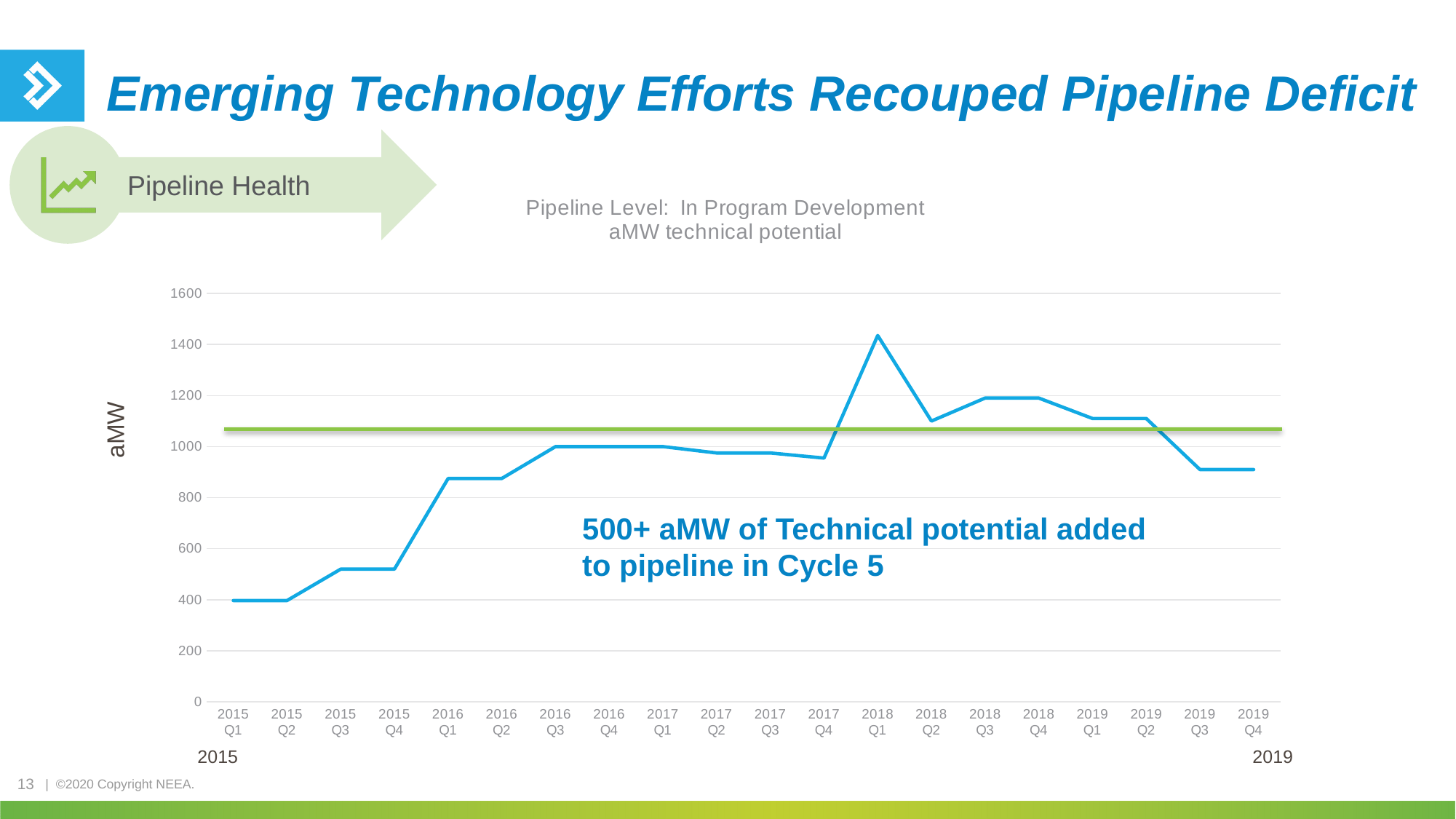
How many quarterly data points are plotted along the x axis? 20 Is the value for 2016 Q1 greater or less than 800? greater Do the values rise or fall from 2015 Q1 to 2016 Q3? rise What kind of chart is shown on the slide? line chart Which is larger, the value for 2018 Q1 or the value for 2019 Q4? 2018 Q1 Is the value for 2019 Q4 greater or less than 1000? less Is the value for 2018 Q1 greater or less than 1200? greater What is the label on the y axis of the chart? aMW Do the values rise or fall from 2018 Q1 to 2018 Q2? fall Which quarter has the highest aMW value on the chart? 2018 Q1